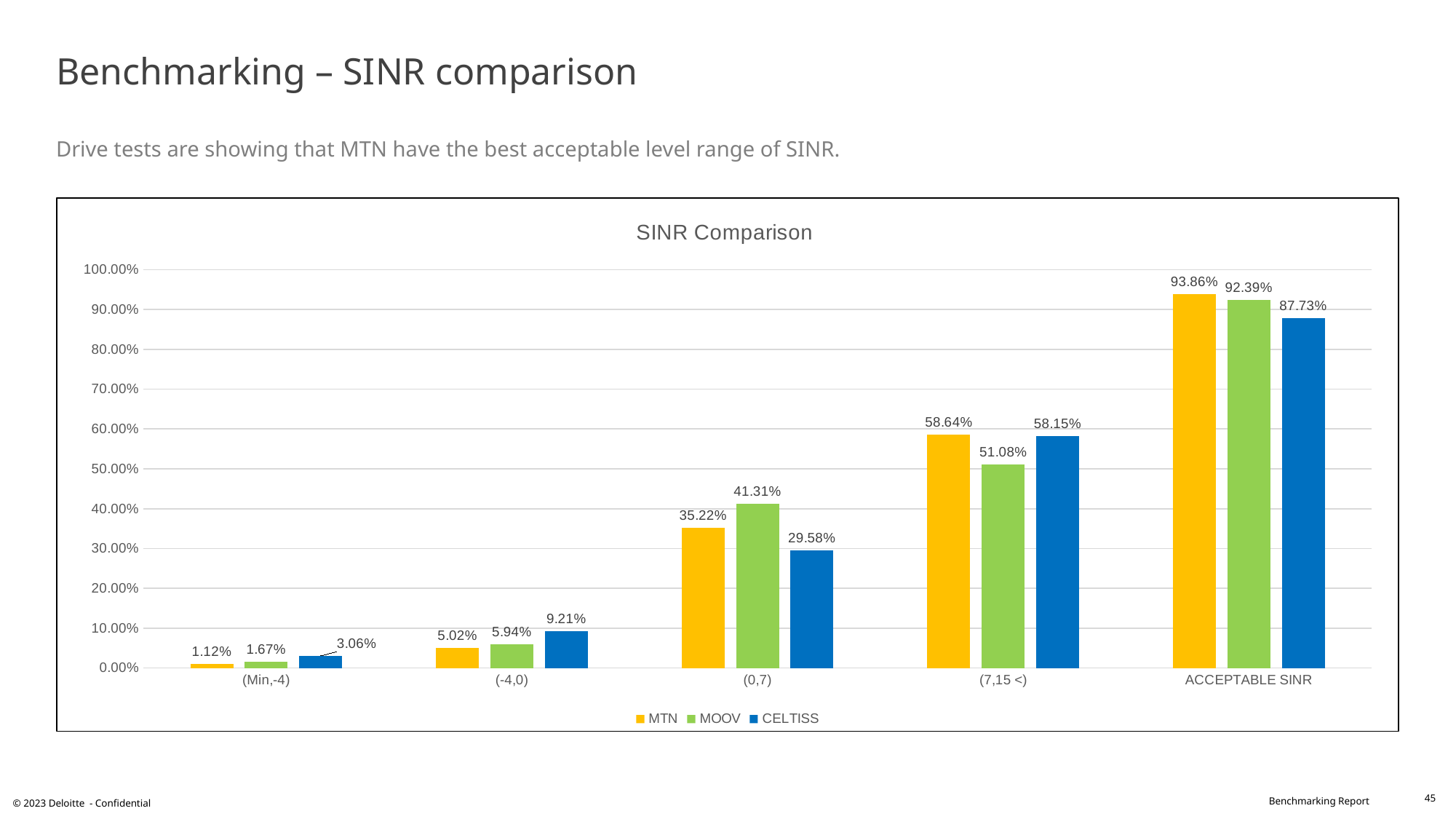
What is the difference between the MTN and CELTISS values for ACCEPTABLE SINR? 6.13% Which series has the highest value in the (0,7) category? MOOV What is the CELTISS value for the (0,7) category? 29.58% What kind of chart is shown? bar chart Which is larger in the (7,15 <) category, MTN or MOOV? MTN How many categories are shown on the x axis? 5 What is the MOOV value for the (-4,0) category? 5.94% Is the MOOV value for (7,15 <) greater or less than 60.00%? less Which series has the lowest value in the (Min,-4) category? MTN How many series does the legend list? 3 What is the MTN value for ACCEPTABLE SINR? 93.86% What is the title of the chart? SINR Comparison